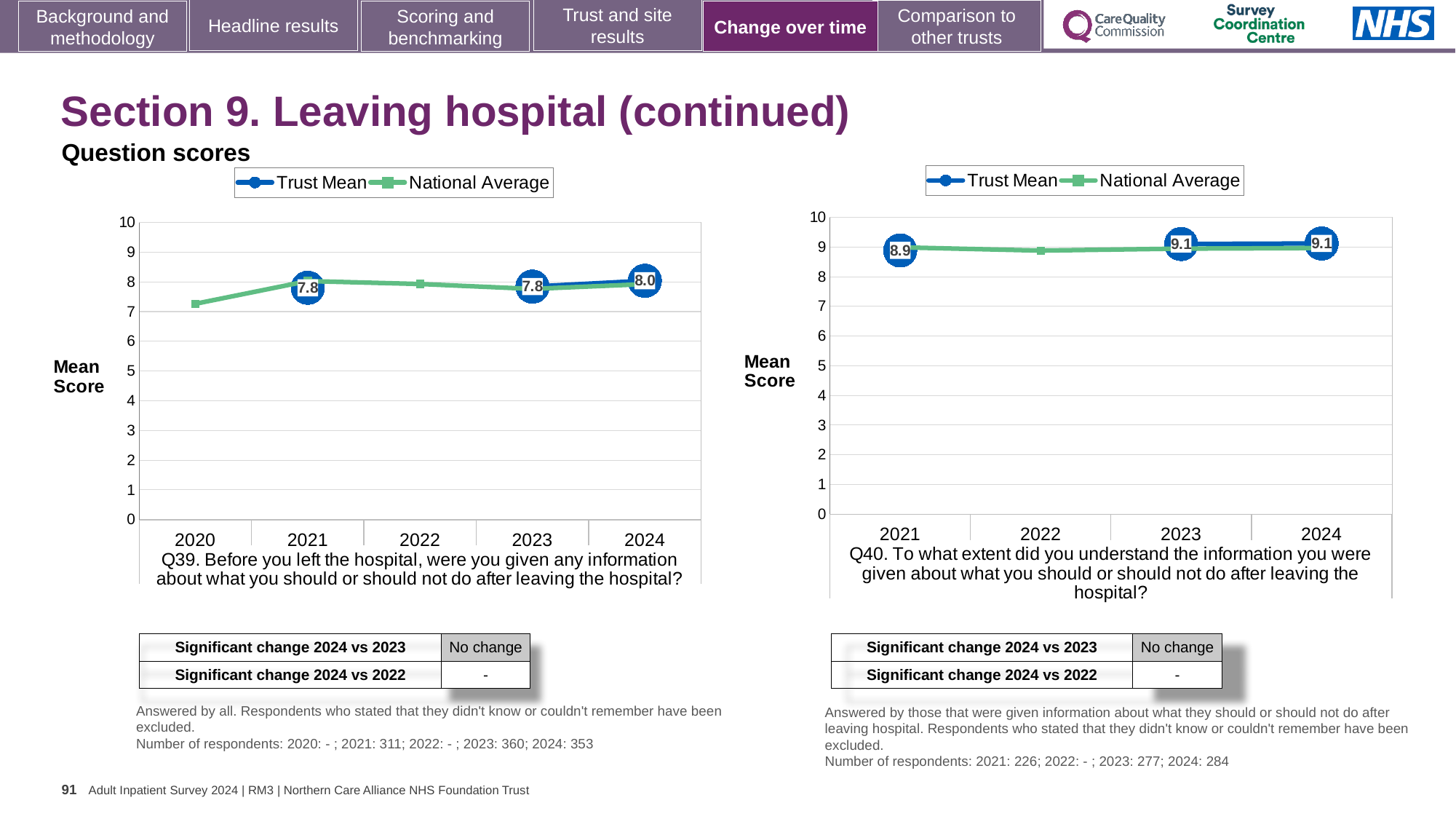
In the Q39 chart on the left, what is the Trust Mean score for 2024? 8.0 In the Q39 chart on the left, is the National Average value for 2020 greater or less than 8? less How many years are shown on the x axis of the Q39 chart on the left? 5 In the Q40 chart on the right, what is the Trust Mean score for 2021? 8.9 In the Q40 chart on the right, what is the Trust Mean score for 2023? 9.1 In the Q40 chart on the right, does the Trust Mean rise or fall from 2021 to 2024? Rise In the Q39 chart on the left, what is the Trust Mean score for 2021? 7.8 How many years are shown on the x axis of the Q40 chart on the right? 4 In the Q39 chart on the left, what is the difference between the Trust Mean scores for 2024 and 2023? 0.2 What type of chart is the Q39 chart on the left? Line chart In the Q40 chart on the right, which year has a higher Trust Mean score, 2021 or 2024? 2024 How many series does the legend of the Q40 chart on the right list? 2